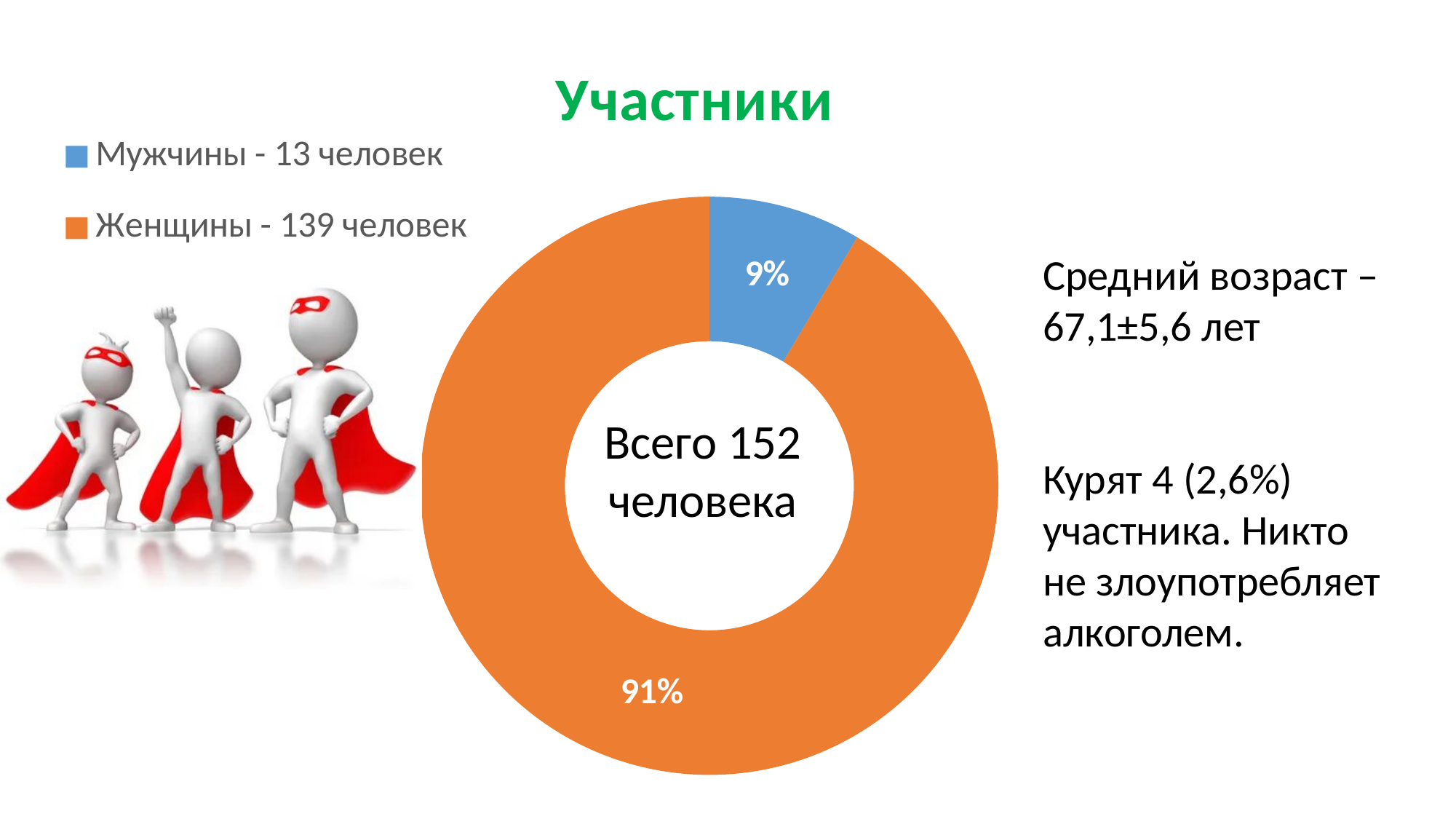
How many people are in the 'Женщины' category according to the legend? 139 человек What colour is the 'Мужчины' slice? Blue What total number of participants is written in the centre of the chart? Всего 152 человека How many people are in the 'Мужчины' category according to the legend? 13 человек Which category has the largest share of the chart? Женщины What is the difference in percentage points between the 'Женщины' and 'Мужчины' slices? 82% Which category has the smallest share of the chart? Мужчины How many categories does the chart show? 2 What kind of chart is shown on the slide? Doughnut (pie) chart What percentage share does the 'Женщины' slice have? 91% What percentage share does the 'Мужчины' slice have? 9% Which is larger, the share for 'Мужчины' or for 'Женщины'? Женщины